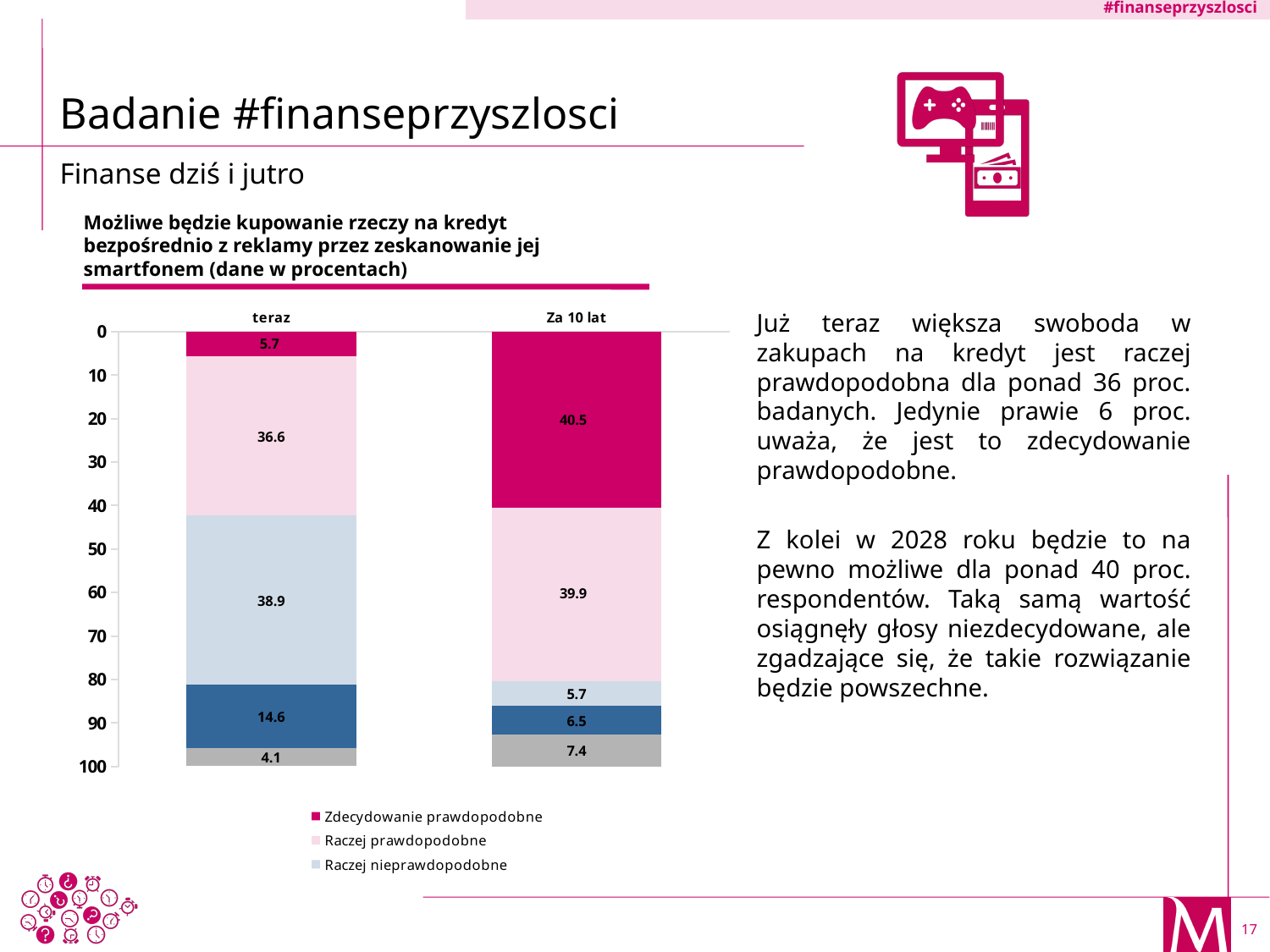
What is the value of 'Raczej nieprawdopodobne' for 'teraz'? 38.9 What type of chart is shown on the slide? stacked bar chart What is the value of 'Raczej nieprawdopodobne' for 'Za 10 lat'? 5.7 What is the value of 'Raczej prawdopodobne' for 'teraz'? 36.6 How many categories (bars) are shown on the x axis? 2 How many series does the legend list? 3 Which category has the larger 'Raczej nieprawdopodobne' value, 'teraz' or 'Za 10 lat'? teraz Which category has the larger 'Raczej prawdopodobne' value, 'teraz' or 'Za 10 lat'? Za 10 lat What is the difference between the 'Zdecydowanie prawdopodobne' values for 'Za 10 lat' and 'teraz'? 34.8 What is the total of all segments in the 'Za 10 lat' bar? 100.0 What is the value of 'Zdecydowanie prawdopodobne' for 'Za 10 lat'? 40.5 What is the value of 'Zdecydowanie prawdopodobne' for 'teraz'? 5.7